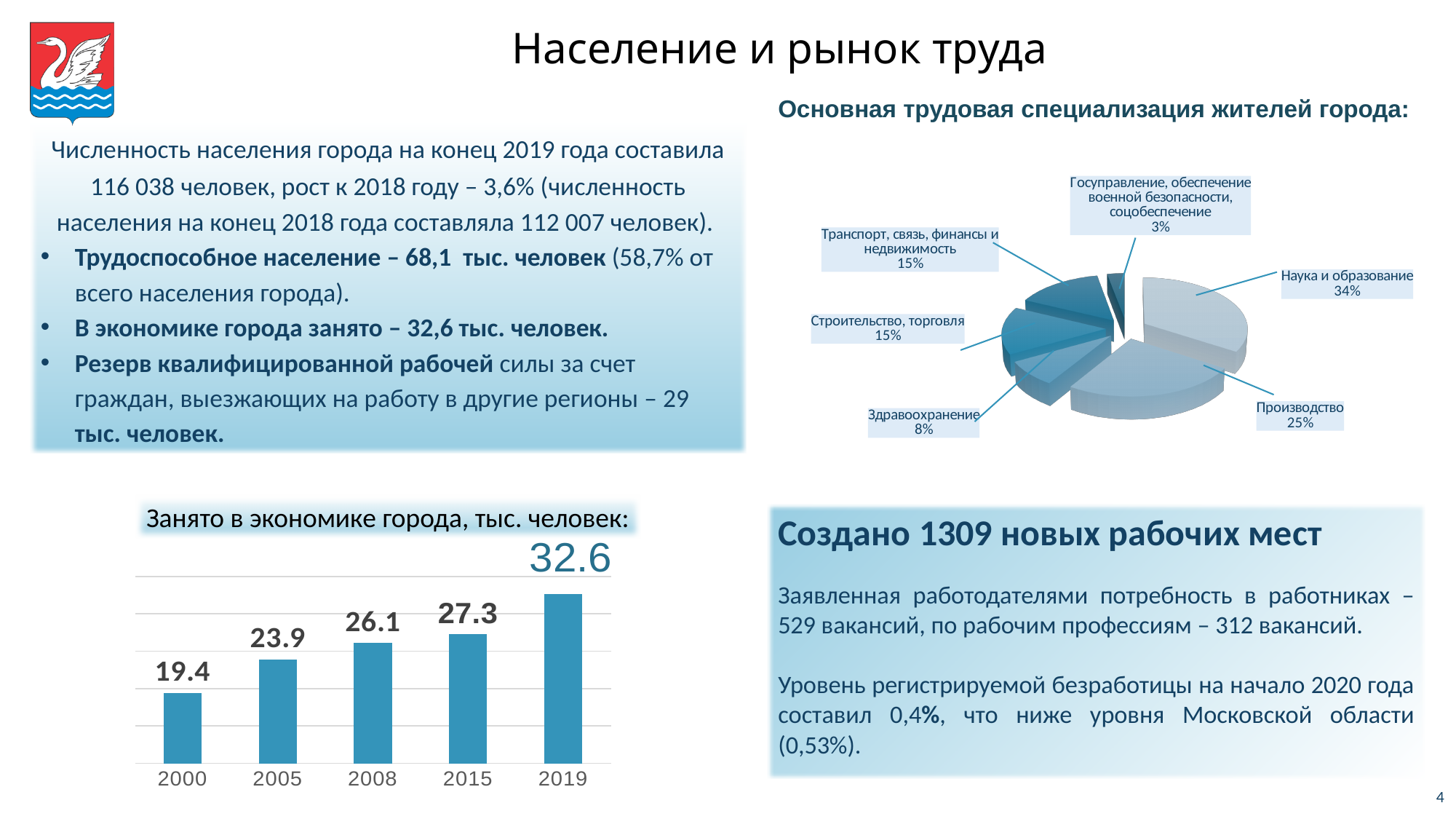
In the bar chart 'Занято в экономике города, тыс. человек', which year has the lowest value? 2000 In the pie chart 'Основная трудовая специализация жителей города', which category has the smallest share? Госуправление, обеспечение военной безопасности, соцобеспечение In the bar chart 'Занято в экономике города, тыс. человек', what is the value for 2019? 32.6 In the pie chart 'Основная трудовая специализация жителей города', what share is 'Производство'? 25% In the bar chart 'Занято в экономике города, тыс. человек', which year has the highest value? 2019 In the bar chart 'Занято в экономике города, тыс. человек', do the values rise or fall from 2000 to 2019? rise In the pie chart 'Основная трудовая специализация жителей города', how many categories are shown? 6 In the bar chart 'Занято в экономике города, тыс. человек', what is the value for 2000? 19.4 In the pie chart 'Основная трудовая специализация жителей города', what share is 'Наука и образование'? 34% In the bar chart 'Занято в экономике города, тыс. человек', what is the difference between the 2019 and 2015 values? 5.3 In the bar chart 'Занято в экономике города, тыс. человек', how many years are shown? 5 What kind of chart is 'Занято в экономике города, тыс. человек'? bar chart